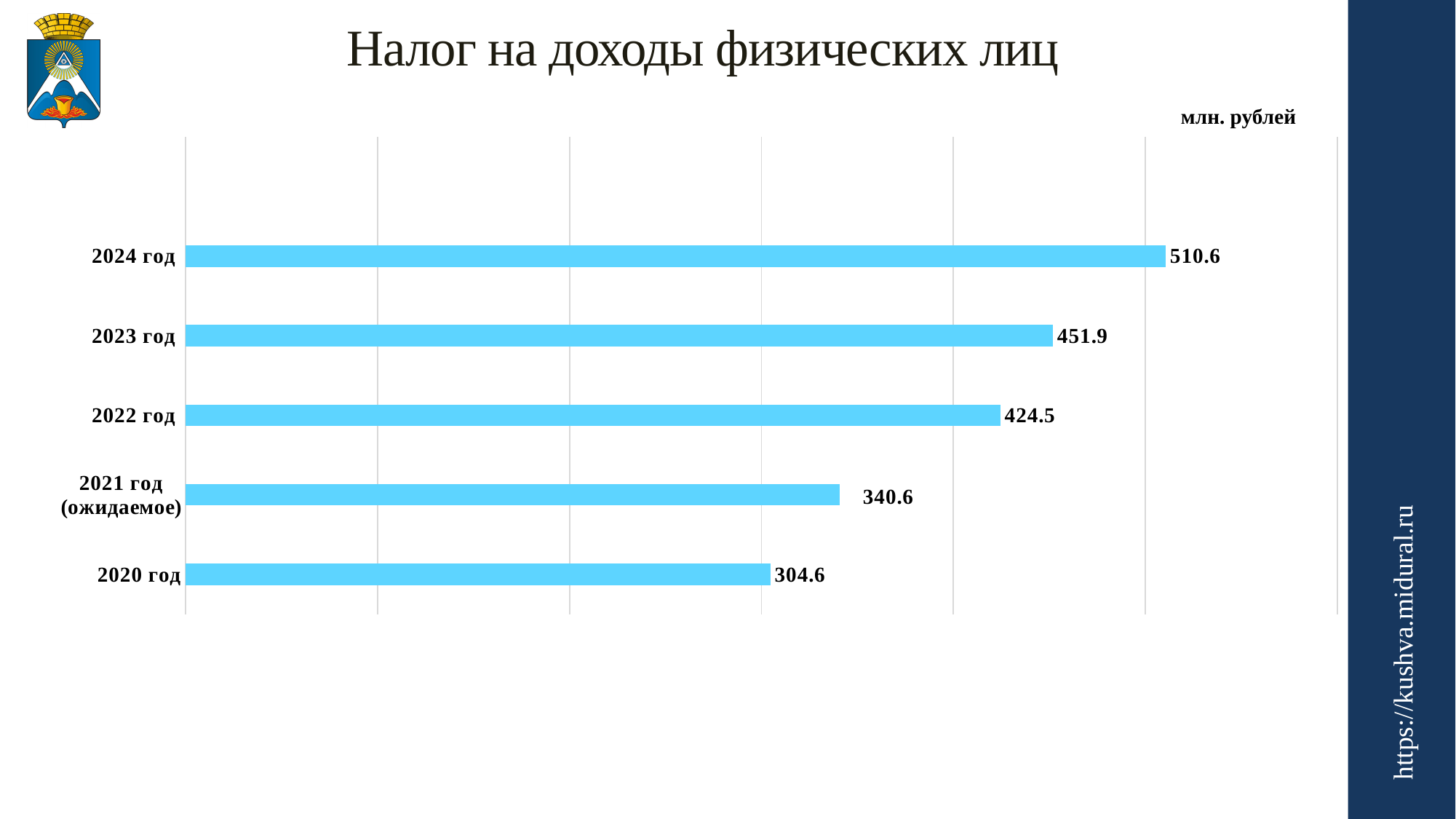
What is the title of the chart? Налог на доходы физических лиц What is the value for 2021 год (ожидаемое)? 340.6 What is the value for 2020 год? 304.6 Which is larger, the value for 2023 год or the value for 2022 год? 2023 год What is the value for 2024 год? 510.6 What kind of chart is shown on the slide? bar chart How many years are shown in the chart? 5 What is the difference between the values for 2022 год and 2020 год? 119.9 Which year has the lowest value? 2020 год Which year has the highest value? 2024 год Do the values rise or fall from 2020 год to 2024 год? rise What is the difference between the values for 2024 год and 2023 год? 58.7